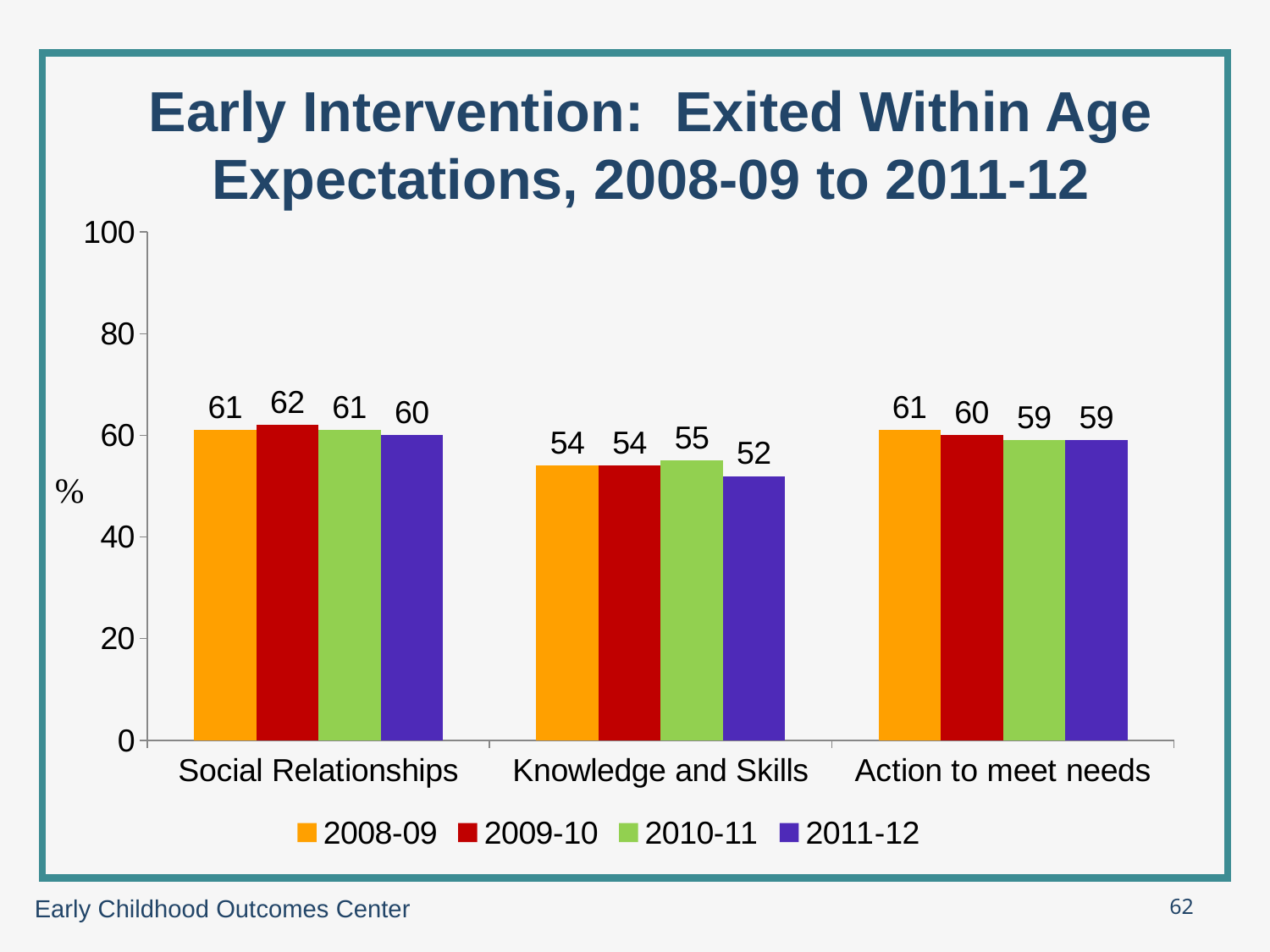
What is the title of the chart? Early Intervention: Exited Within Age Expectations, 2008-09 to 2011-12 Which year has the highest value for Social Relationships? 2009-10 What kind of chart is shown on the slide? bar chart Which is larger: the 2008-09 value for Social Relationships or the 2008-09 value for Knowledge and Skills? Social Relationships How many series does the legend list? 4 What is the value for Social Relationships in 2009-10? 62 What is the value for Knowledge and Skills in 2011-12? 52 Is the value for Knowledge and Skills in 2011-12 greater or less than 60? less What is the difference between the 2010-11 and 2011-12 values for Knowledge and Skills? 3 Which category has the lowest value in 2011-12? Knowledge and Skills What is the value for Action to meet needs in 2008-09? 61 How many categories are shown on the x axis? 3